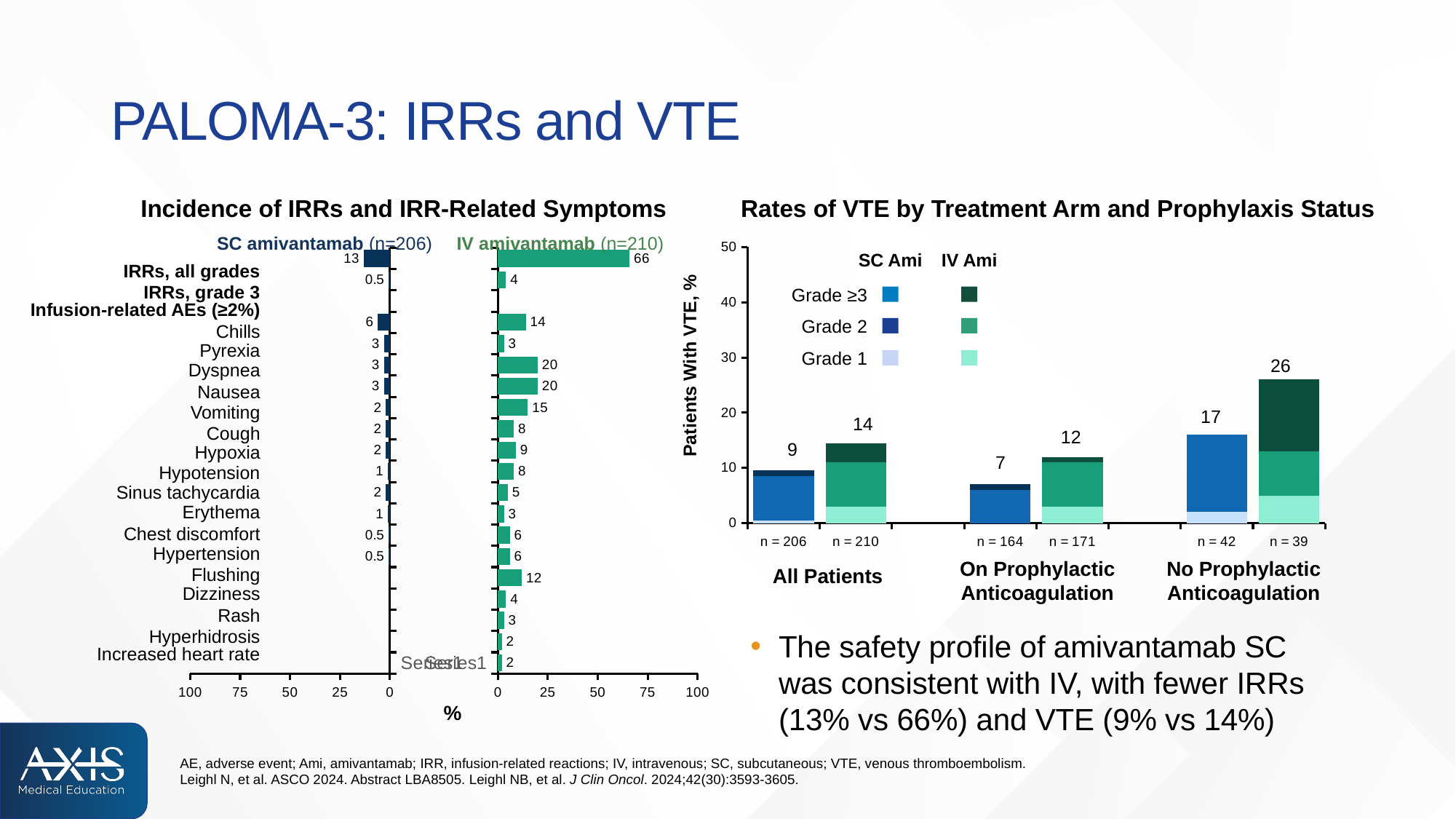
In the 'Rates of VTE by Treatment Arm and Prophylaxis Status' chart, which bar has the lowest total VTE rate? SC Ami, On Prophylactic Anticoagulation In the 'Rates of VTE by Treatment Arm and Prophylaxis Status' chart, what is the VTE rate for IV Ami in the No Prophylactic Anticoagulation group? 26 In the 'Rates of VTE by Treatment Arm and Prophylaxis Status' chart, which bar has the highest total VTE rate? IV Ami, No Prophylactic Anticoagulation In the 'Rates of VTE by Treatment Arm and Prophylaxis Status' chart, what is the y-axis label? Patients With VTE, % In the 'Incidence of IRRs and IRR-Related Symptoms' chart, what is the value for IRRs, all grades with SC amivantamab? 13 In the 'Rates of VTE by Treatment Arm and Prophylaxis Status' chart, which is larger: the SC Ami rate in the No Prophylactic Anticoagulation group or the IV Ami rate for All Patients? SC Ami, No Prophylactic Anticoagulation In the 'Rates of VTE by Treatment Arm and Prophylaxis Status' chart, how many grade levels does the legend distinguish? 3 In the 'Rates of VTE by Treatment Arm and Prophylaxis Status' chart, what is the difference between the IV Ami and SC Ami VTE rates for All Patients? 5 In the 'Incidence of IRRs and IRR-Related Symptoms' chart, is the IV amivantamab value for IRRs, all grades greater or less than 50? greater What kind of chart is 'Rates of VTE by Treatment Arm and Prophylaxis Status'? Stacked bar chart In the 'Incidence of IRRs and IRR-Related Symptoms' chart, what is the value for IRRs, all grades with IV amivantamab? 66 In the 'Incidence of IRRs and IRR-Related Symptoms' chart, what is the difference between the IV and SC amivantamab values for IRRs, all grades? 53